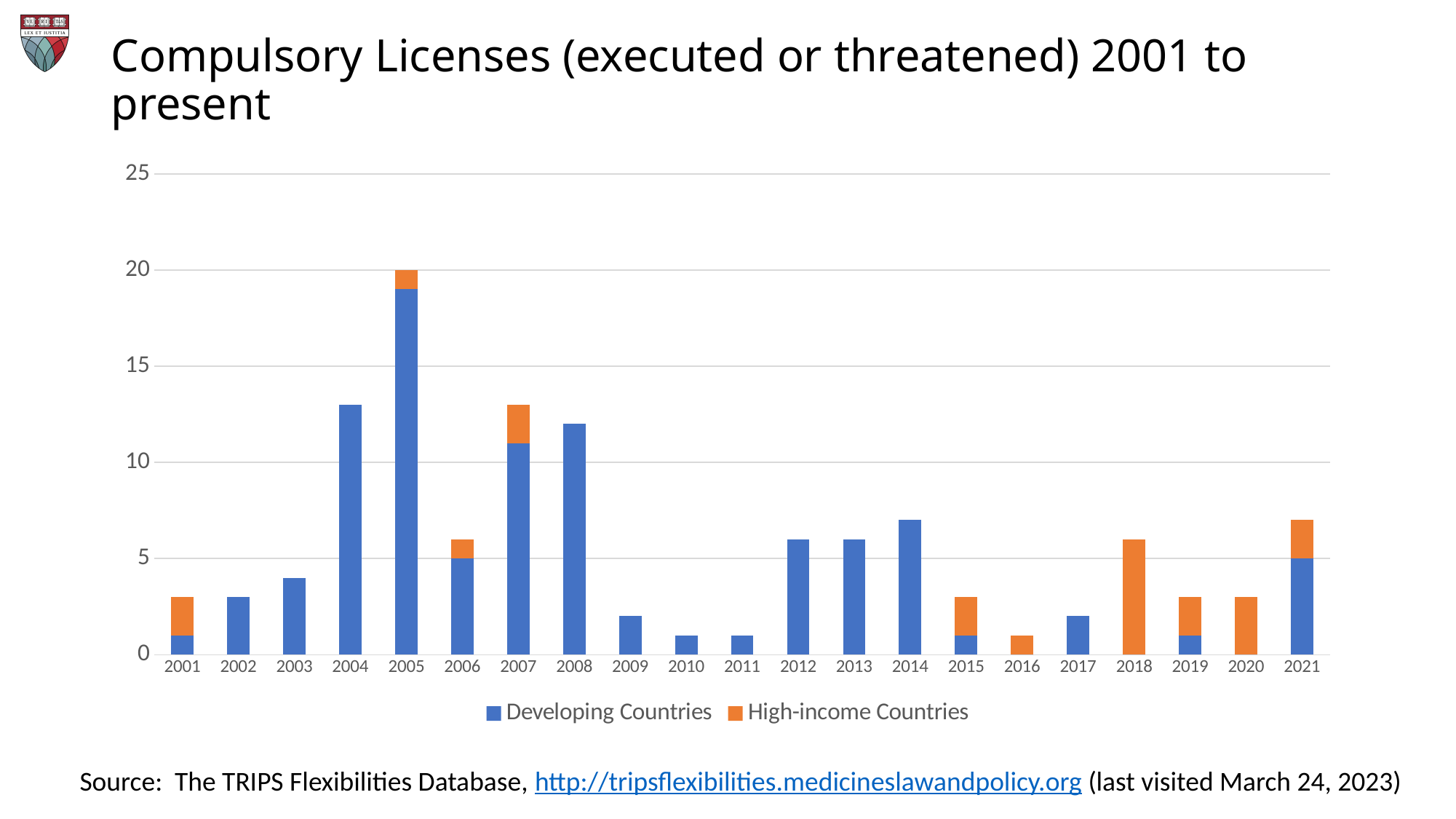
What kind of chart is shown on the slide? bar chart Do the total values rise or fall from 2008 to 2010? fall Is the total value for 2004 greater or less than 10? greater Which year has the highest total number of compulsory licenses? 2005 What is the value for Developing Countries in 2006? 5 How many series does the legend list? 2 How many years are shown on the x axis? 21 Is the total value for 2009 greater or less than 5? less Which is larger, the total for 2004 or the total for 2014? 2004 What is the total height of the stacked bar for 2005? 20 Which colour represents High-income Countries in the legend? orange What is the value for Developing Countries in 2021? 5